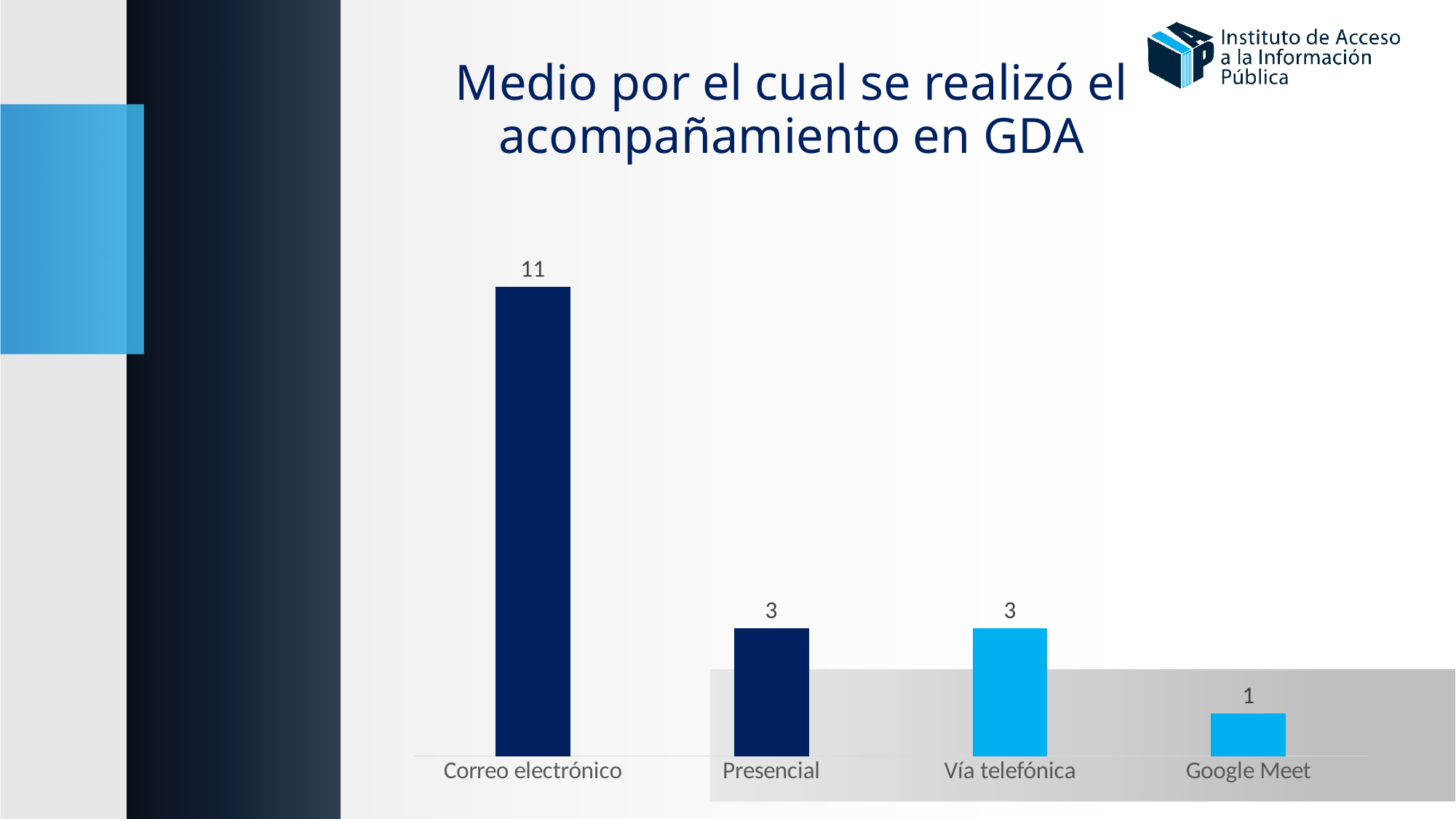
What kind of chart is shown on the slide? Bar chart Which category has the lowest value? Google Meet What is the difference between the values for Vía telefónica and Google Meet? 2 What is the value for Correo electrónico? 11 Which is larger, the value for Correo electrónico or the value for Google Meet? Correo electrónico What is the difference between the values for Correo electrónico and Presencial? 8 What is the value for Google Meet? 1 What is the value for Presencial? 3 What is the title of the chart? Medio por el cual se realizó el acompañamiento en GDA How many categories are shown in the chart? 4 Which category has the highest value? Correo electrónico What is the value for Vía telefónica? 3